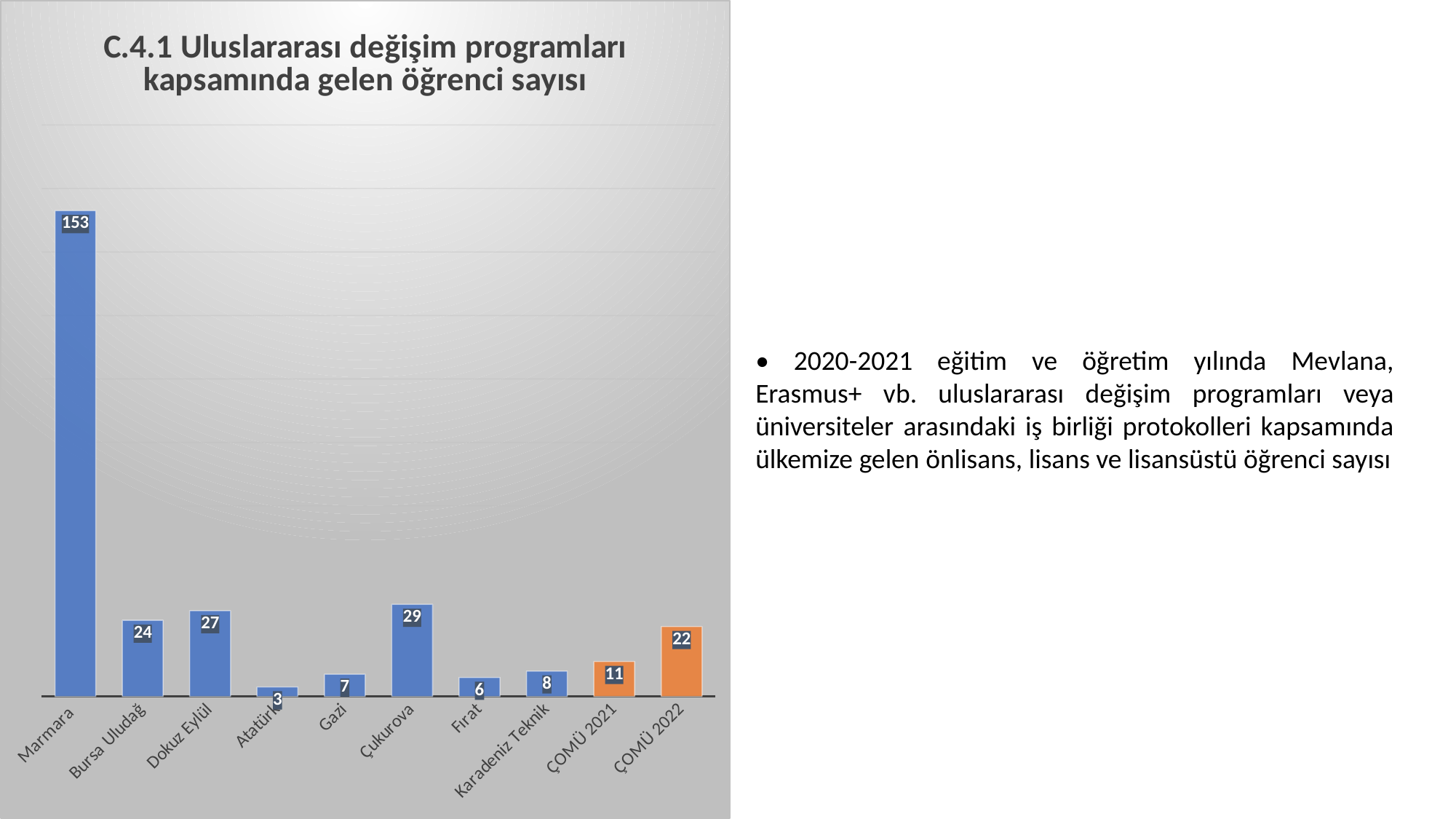
Which category has the highest value? Marmara What is the title of the chart? C.4.1 Uluslararası değişim programları kapsamında gelen öğrenci sayısı What is the difference between the values for ÇOMÜ 2022 and ÇOMÜ 2021? 11 How many categories are shown on the x axis? 10 Which category has the lowest value? Atatürk What is the value for Çukurova? 29 What is the value for Karadeniz Teknik? 8 What is the value for ÇOMÜ 2022? 22 Which is larger, the value for Dokuz Eylül or the value for Bursa Uludağ? Dokuz Eylül What kind of chart is this? Bar chart What is the difference between the values for Marmara and Çukurova? 124 What is the value for Marmara? 153